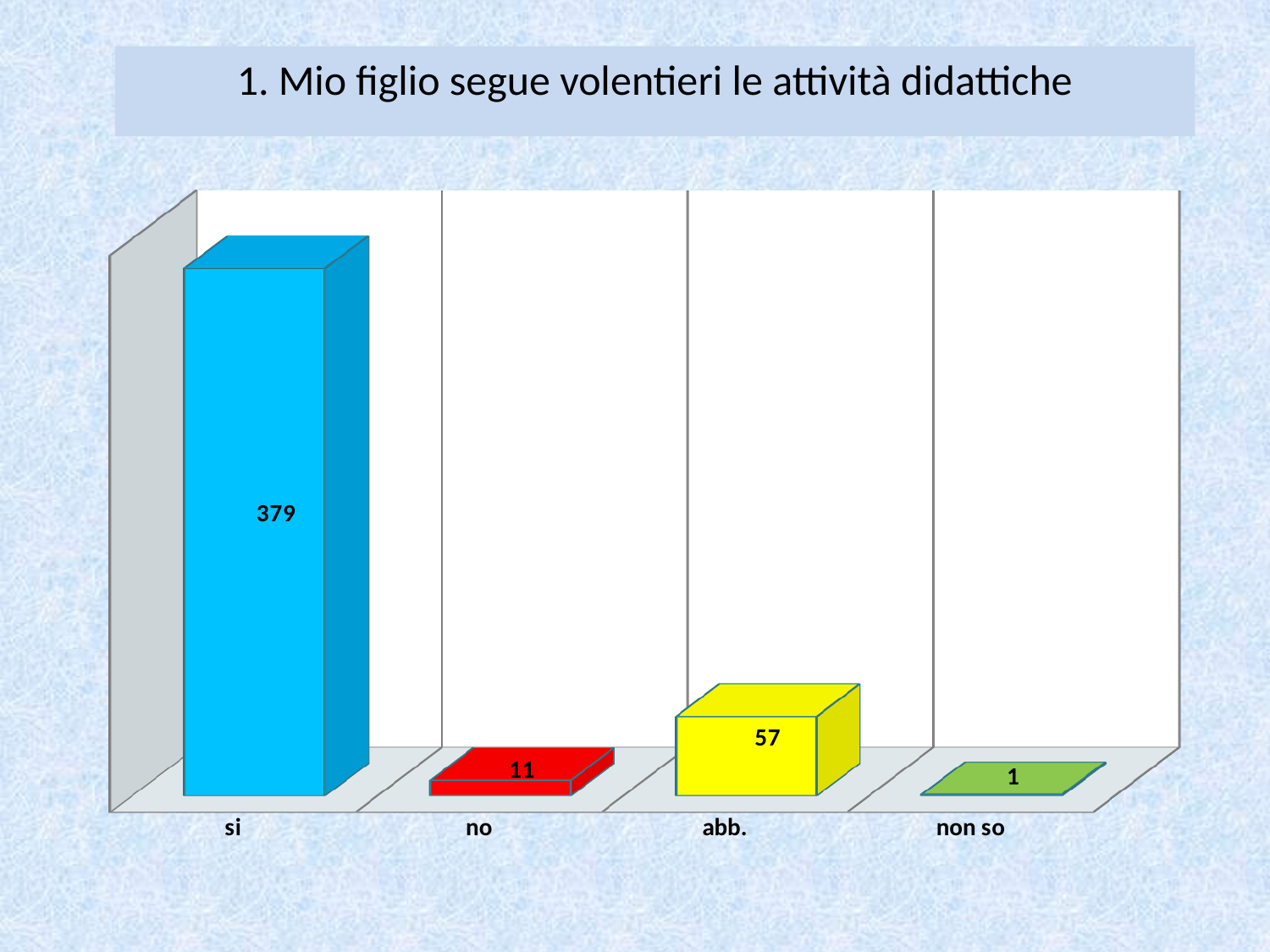
What is the value for "abb."? 57 Which category has the highest value? si What is the value for "si"? 379 What is the difference between the values for "abb." and "no"? 46 How many categories are shown on the x axis? 4 What kind of chart is shown on the slide? bar chart Which category has the lowest value? non so What is the value for "non so"? 1 Which is larger, the value for "no" or the value for "abb."? abb. What is the title of the slide above the chart? 1. Mio figlio segue volentieri le attività didattiche What is the difference between the values for "si" and "abb."? 322 What is the value for "no"? 11